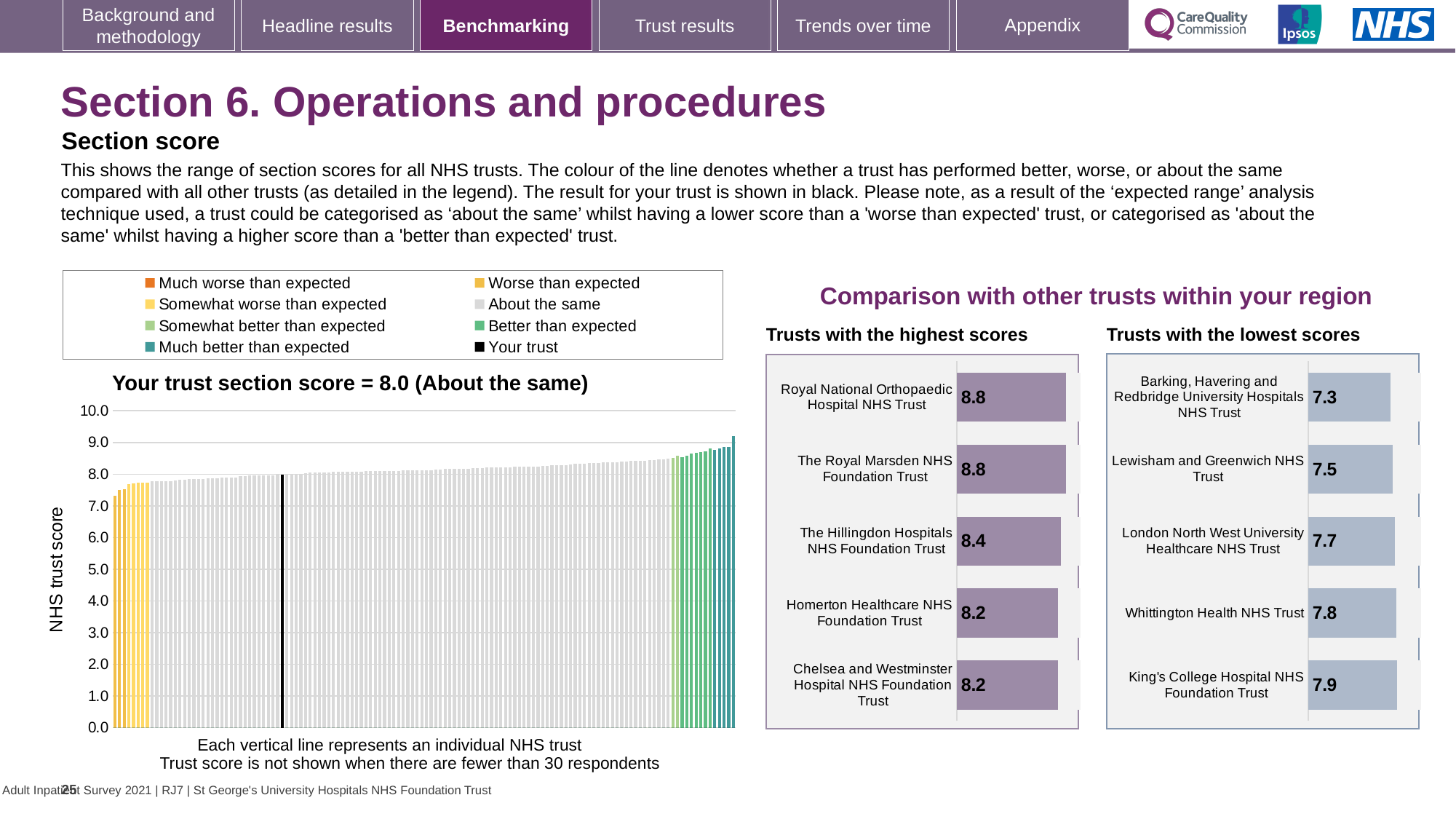
In the 'Trusts with the lowest scores' chart, which trust has the lowest score? Barking, Havering and Redbridge University Hospitals NHS Trust What kind of chart is the 'Your trust section score' chart on the left? Bar chart In the 'Your trust section score' chart, do the trust scores rise or fall from left to right? Rise In the 'Trusts with the lowest scores' chart, which trust has the highest score? King's College Hospital NHS Foundation Trust How many trusts are shown in the 'Trusts with the highest scores' chart? 5 According to the title of the left chart, what is your trust's section score? 8.0 In the 'Trusts with the lowest scores' chart, which has the larger score: Whittington Health NHS Trust or Lewisham and Greenwich NHS Trust? Whittington Health NHS Trust In the 'Trusts with the highest scores' chart, what is the difference between the scores of Royal National Orthopaedic Hospital NHS Trust and The Hillingdon Hospitals NHS Foundation Trust? 0.4 How many entries does the legend above the 'Your trust section score' chart list? 8 In the 'Trusts with the highest scores' chart, what is the score for The Hillingdon Hospitals NHS Foundation Trust? 8.4 In the 'Trusts with the lowest scores' chart, what is the score for Barking, Havering and Redbridge University Hospitals NHS Trust? 7.3 In the 'Trusts with the lowest scores' chart, what is the difference between the scores of King's College Hospital NHS Foundation Trust and Barking, Havering and Redbridge University Hospitals NHS Trust? 0.6